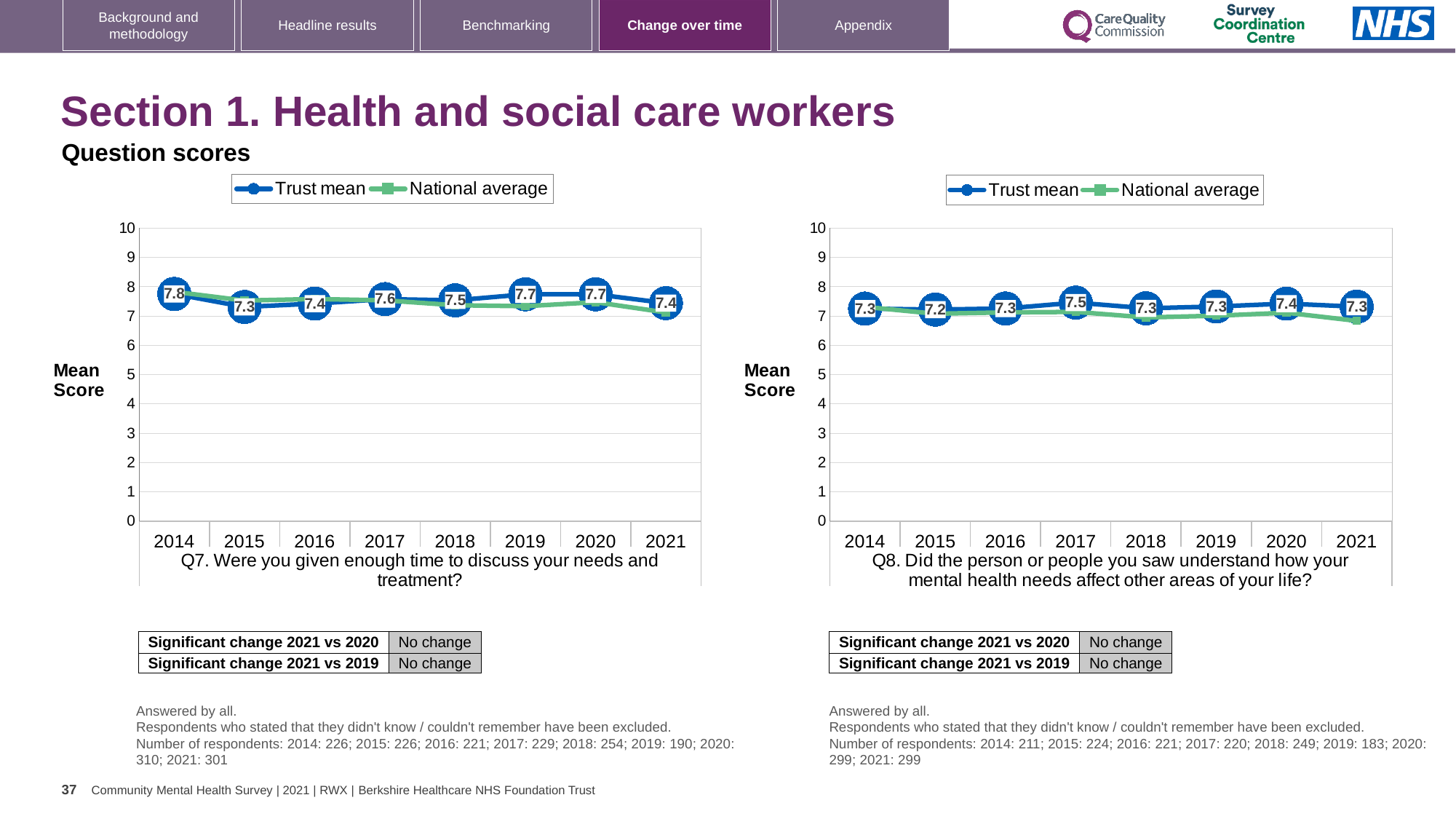
How many series does the legend of the Q7 chart on the left list? 2 In the Q7 chart on the left, what is the difference between the Trust mean in 2014 and in 2015? 0.5 What type of chart is the Q7 chart on the left? Line chart In the Q8 chart on the right, what is the Trust mean for 2021? 7.3 In the Q8 chart on the right, which year has the lowest Trust mean? 2015 In the Q7 chart on the left, what is the Trust mean for 2014? 7.8 In the Q7 chart on the left, what is the Trust mean for 2021? 7.4 In the Q8 chart on the right, is the Trust mean higher in 2017 or in 2015? 2017 In the Q7 chart on the left, is the Trust mean for 2019 greater or less than 5? greater How many years are shown on the x axis of the Q8 chart on the right? 8 In the Q8 chart on the right, what is the Trust mean for 2017? 7.5 In the Q7 chart on the left, which year has the highest Trust mean? 2014